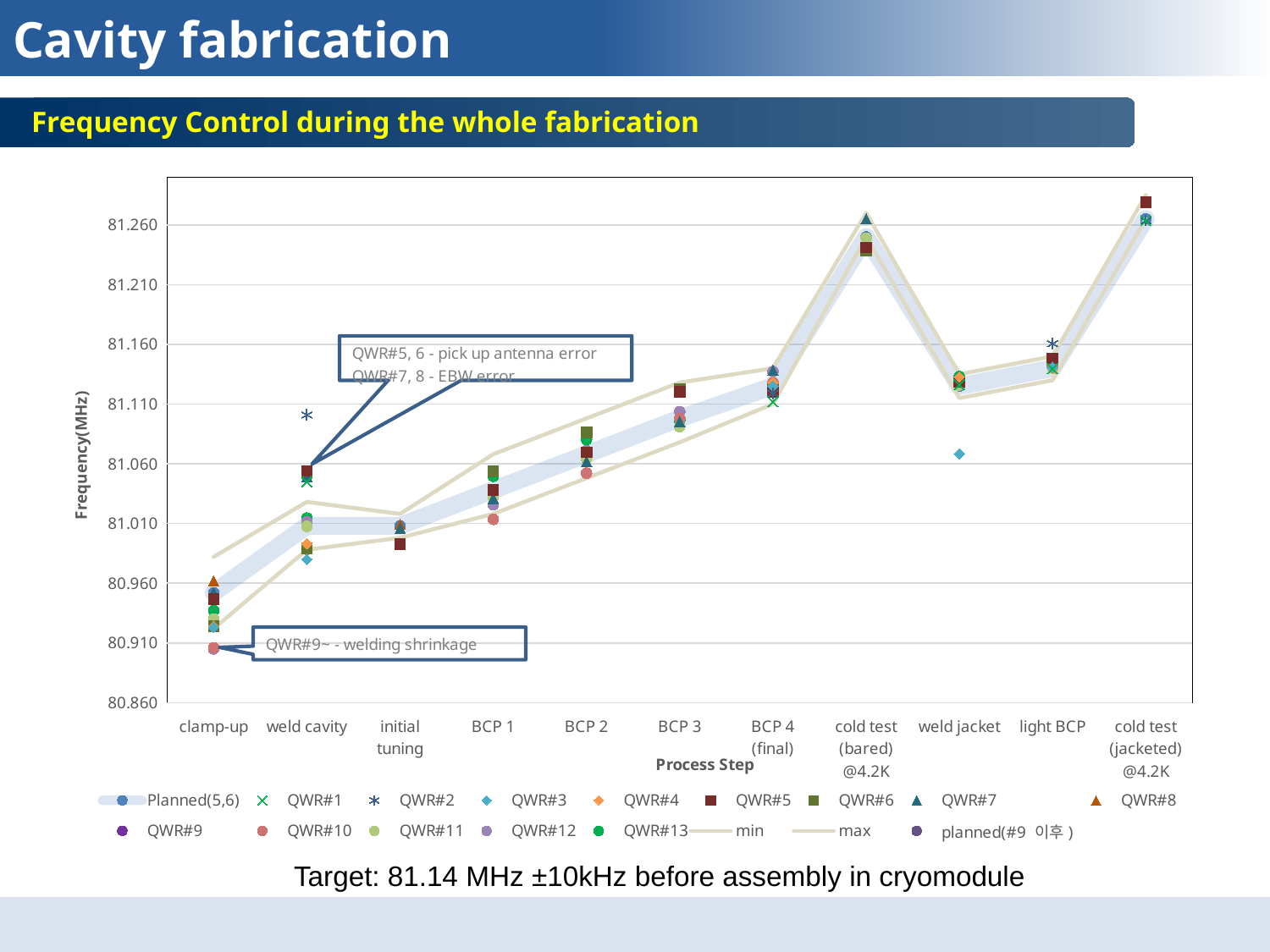
Are the values at cold test (bared) @4.2K greater or less than 81.210? greater Is the value for QWR#2 at weld cavity greater or less than 81.060? greater At which process step do the plotted frequencies reach their highest values? cold test (jacketed) @4.2K Are the frequencies higher at cold test (bared) @4.2K or at weld jacket? cold test (bared) @4.2K How many series does the chart legend list? 17 What is the label of the y axis of the chart? Frequency(MHz) Do the plotted frequencies rise or fall from weld jacket to cold test (jacketed) @4.2K? rise At which process step are the plotted frequencies lowest? clamp-up What is the label of the x axis of the chart? Process Step Are the values at clamp-up greater or less than 81.010? less How many process steps are shown on the x axis of the chart? 11